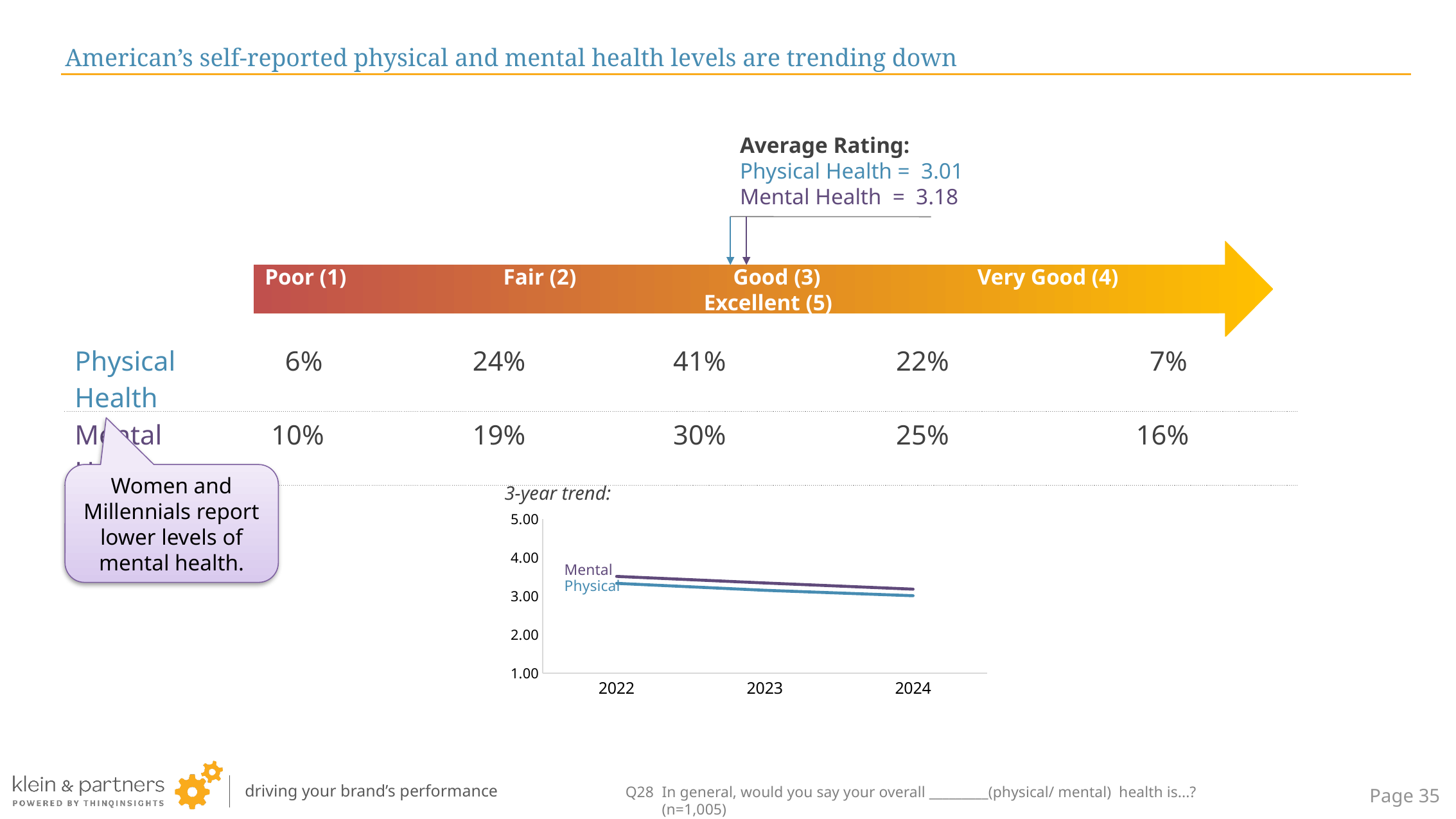
In the 3-year trend chart, which series is higher in 2022, Mental or Physical? Mental In the 3-year trend chart, which year has the lowest Physical value? 2024 In the 3-year trend chart, does the Mental line rise or fall from 2022 to 2024? fall In the 3-year trend chart, is the Physical value for 2024 greater or less than 2.00? greater In the 3-year trend chart, which year has the highest Mental value? 2022 How many series are plotted in the 3-year trend chart? 2 In the 3-year trend chart, does the Physical line rise or fall from 2022 to 2024? fall What is the highest value shown on the y axis of the 3-year trend chart? 5.00 In the 3-year trend chart, is the Mental value for 2022 greater or less than 4.00? less How many years are shown on the x axis of the 3-year trend chart? 3 What kind of chart is the 3-year trend chart? line chart What is the label above the line chart? 3-year trend: